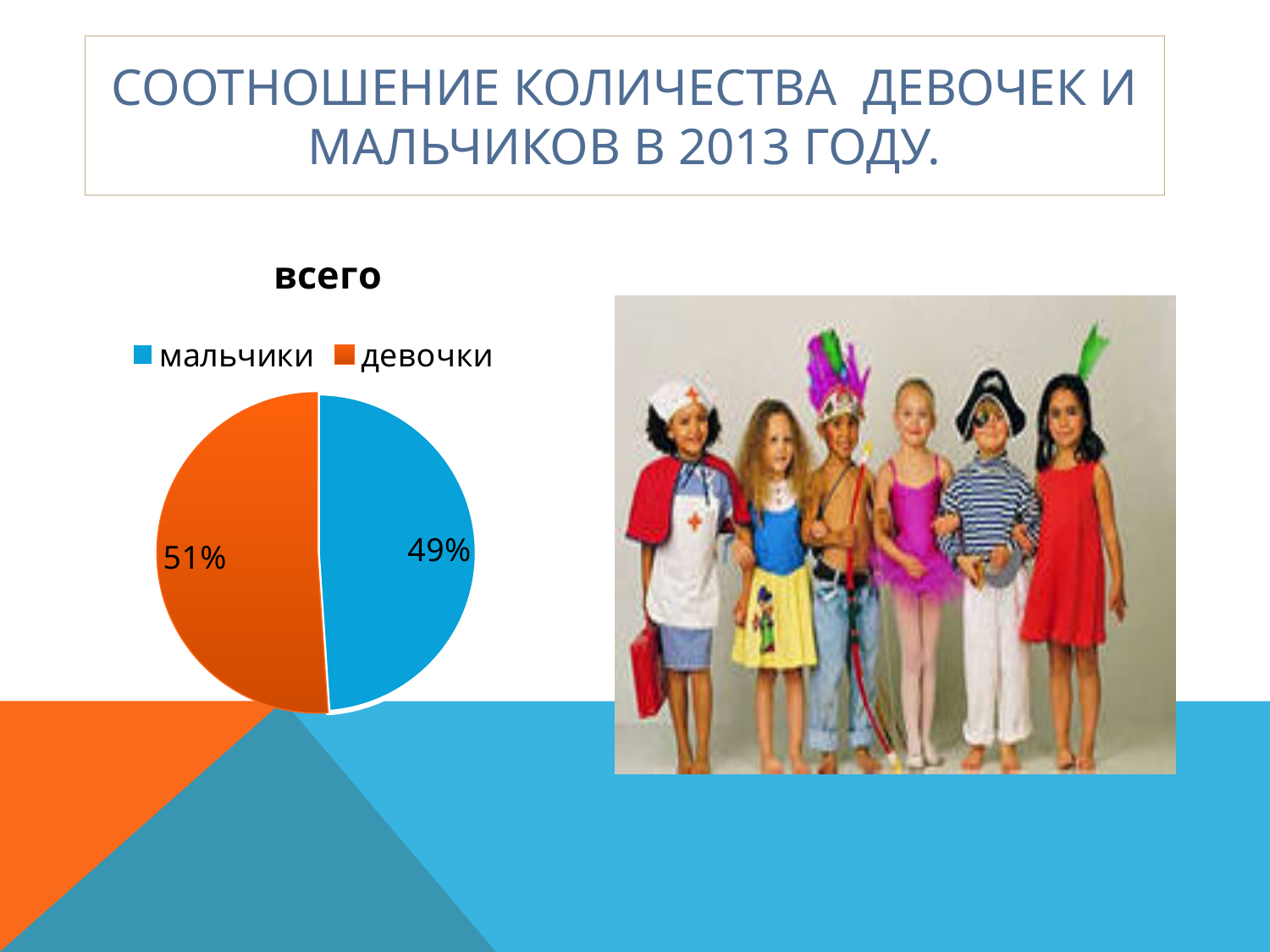
What is the difference in percentage points between the девочки and мальчики slices? 2% How many entries does the legend list? 2 How many slices does the pie chart have? 2 What share of the pie is labelled for девочки? 51% Which category has the smallest share of the pie? мальчики Is the share for мальчики greater or less than 50%? less What share of the pie is labelled for мальчики? 49% Which category has the largest share of the pie? девочки What type of chart is shown on the slide? pie chart What is the title of the chart? всего Which category has the larger share of the pie, мальчики or девочки? девочки What colour is the slice for девочки? orange